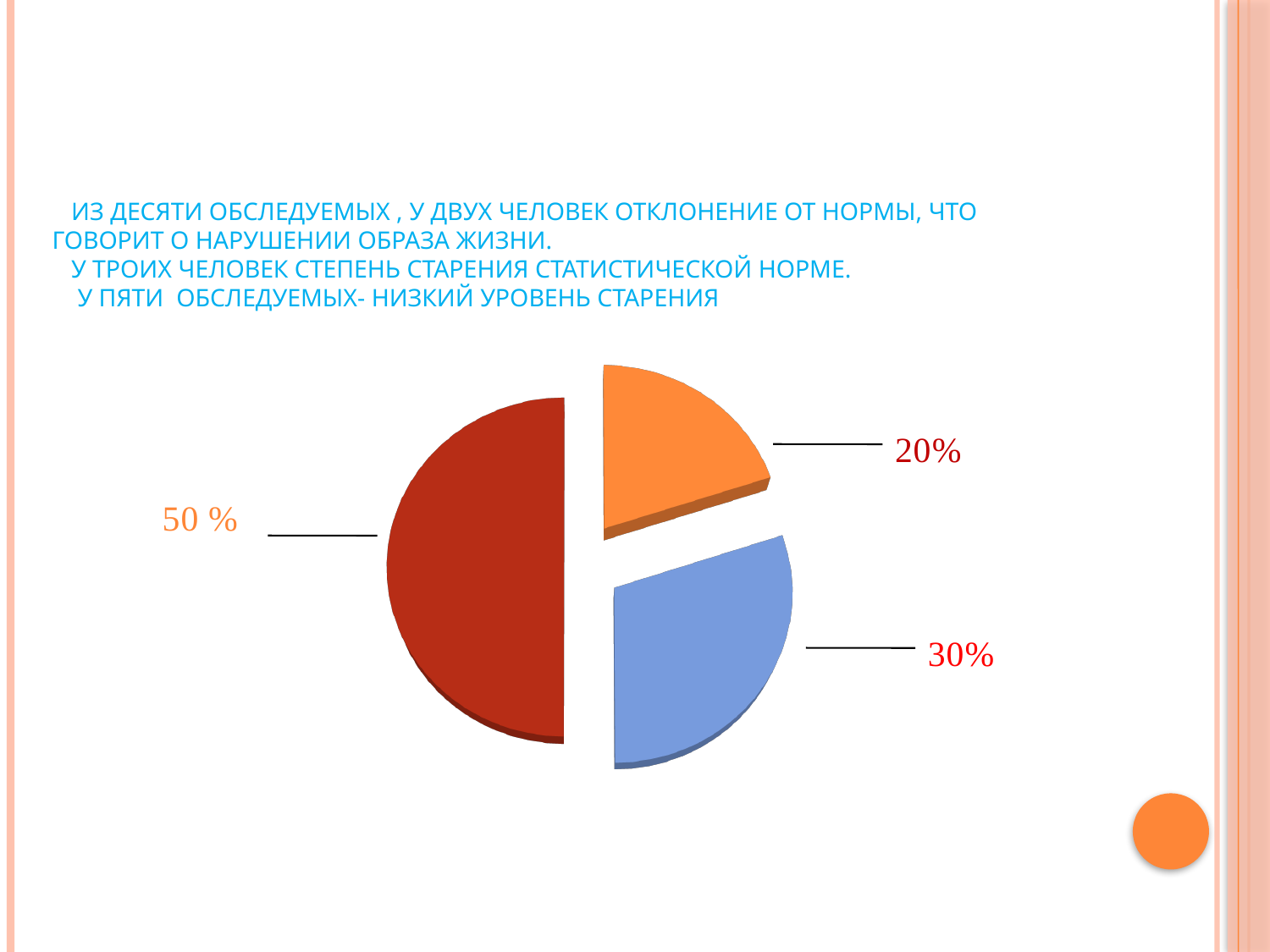
What value is labelled on the blue slice of the pie chart? 30% What is the difference between the red slice and the blue slice of the pie chart? 20 percentage points How many slices does the pie chart have? 3 What is the difference between the blue slice and the orange slice of the pie chart? 10 percentage points What share of the pie does the blue slice represent? 30% What value is labelled on the orange slice of the pie chart? 20% Which is larger in the pie chart, the blue slice or the orange slice? the blue slice What colour is the slice labelled 20% in the pie chart? orange Which slice of the pie chart is the largest? the red slice (50 %) What value is labelled on the red slice of the pie chart? 50 % Which slice of the pie chart is the smallest? the orange slice (20%) What kind of chart is shown on the slide? pie chart